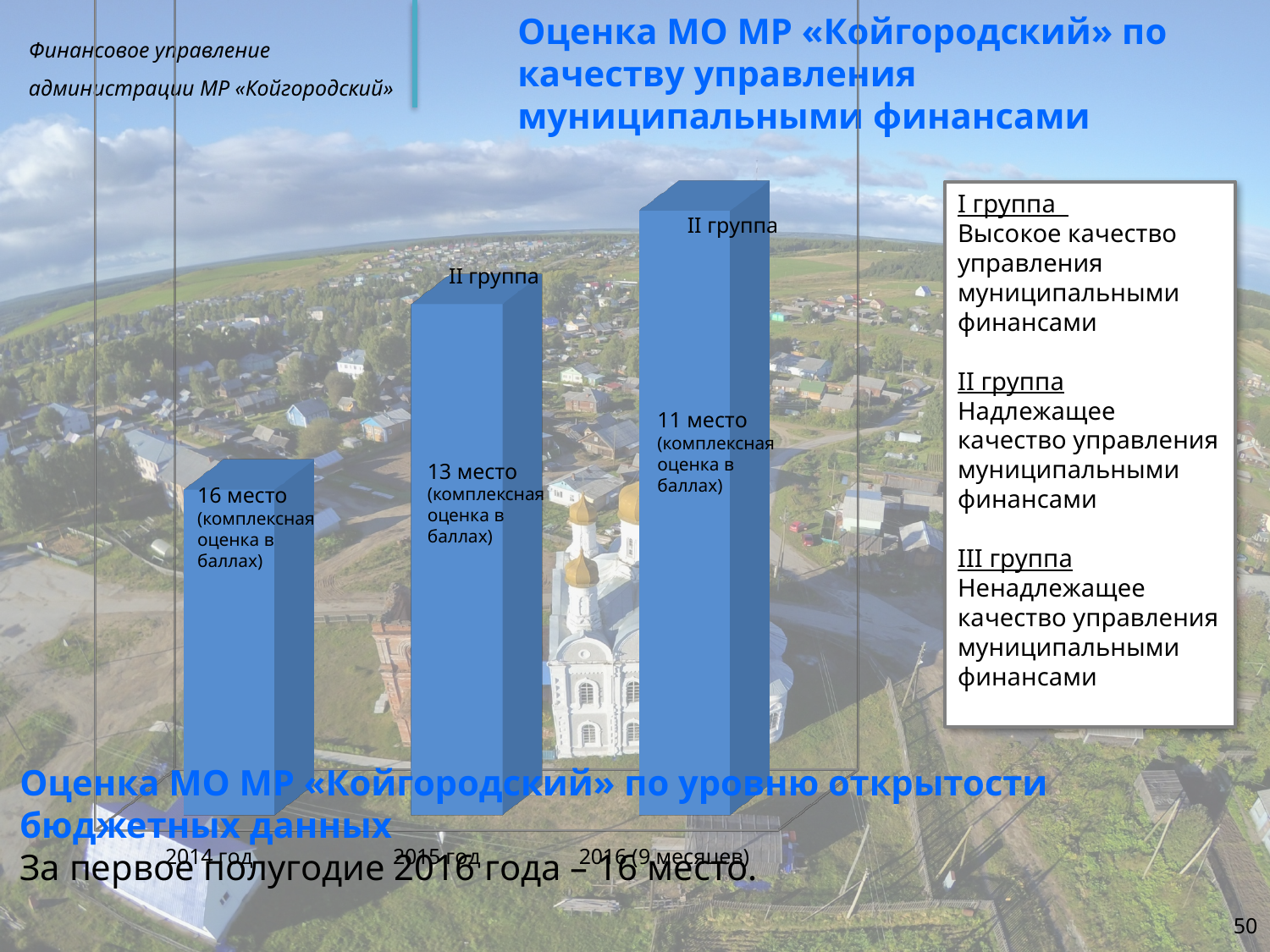
Which group (группа) is labelled above the bars for 2015 год and 2016 (9 месяцев)? II группа What kind of chart is shown on the slide? bar chart What place (место) is labelled on the bar for 2014 год? 16 место What place (место) is labelled on the bar for 2016 (9 месяцев)? 11 место What place (место) is labelled on the bar for 2015 год? 13 место How many bars (years) does the chart show? 3 Do the bars rise or fall from 2014 год to 2016 (9 месяцев)? rise Which year has the tallest bar in the chart? 2016 (9 месяцев) Which year has the shortest bar in the chart? 2014 год By how many places did the ranking improve from 2014 год (16 место) to 2016 (9 месяцев) (11 место)? 5 Which bar is taller: 2014 год or 2015 год? 2015 год What is the title of the chart at the top of the slide? Оценка МО МР «Койгородский» по качеству управления муниципальными финансами